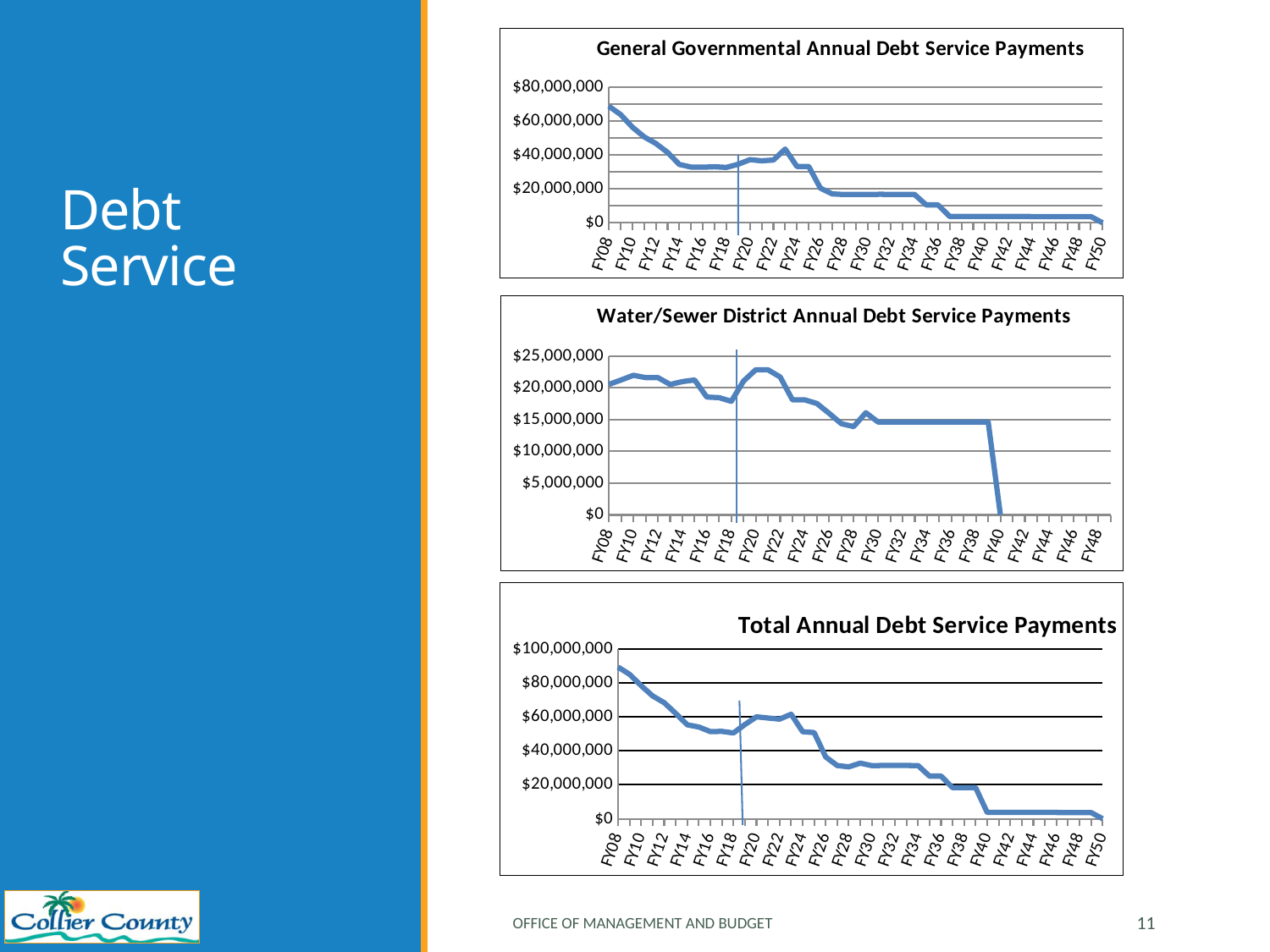
In the "General Governmental Annual Debt Service Payments" chart, do the values generally rise or fall from FY08 to FY50? Fall In the "General Governmental Annual Debt Service Payments" chart, is the value for FY08 greater or less than $60,000,000? greater In the "Total Annual Debt Service Payments" chart, is the value for FY08 greater or less than $80,000,000? greater How many charts are shown on the slide? 3 In the "Total Annual Debt Service Payments" chart, which fiscal year has the highest value? FY08 In the "General Governmental Annual Debt Service Payments" chart, is the value for FY40 greater or less than $20,000,000? less In the "General Governmental Annual Debt Service Payments" chart, which fiscal year has the highest value? FY08 What kind of chart is the "General Governmental Annual Debt Service Payments" chart? Line chart What is the title of the middle chart on the slide? Water/Sewer District Annual Debt Service Payments